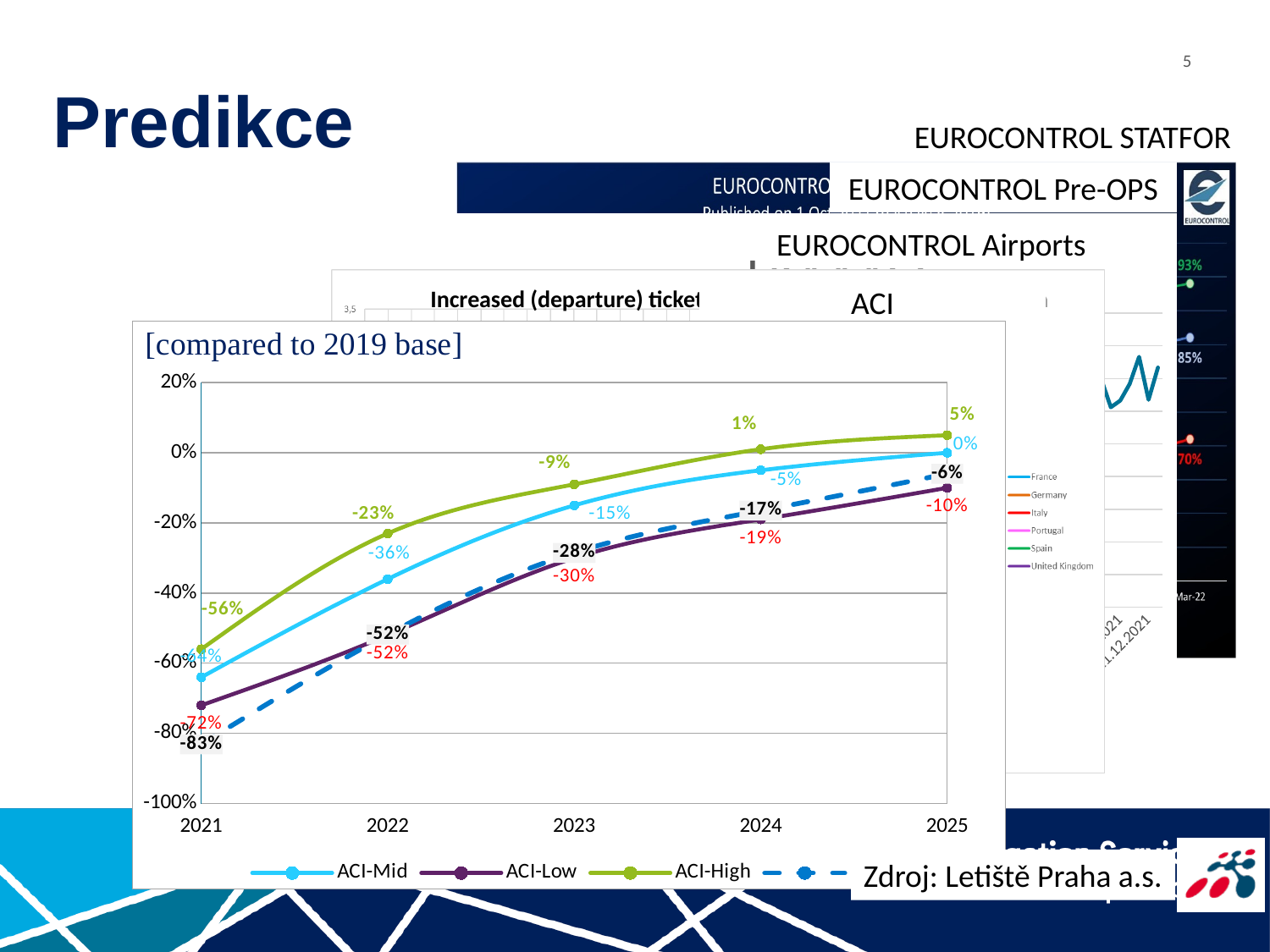
In the front chart '[compared to 2019 base]', what is the ACI-Low value for 2023? -30% In the front chart '[compared to 2019 base]', what is the difference between the ACI-High and ACI-Mid values in 2022? 13 percentage points How many years are shown on the x axis of the front chart '[compared to 2019 base]'? 5 In the front chart '[compared to 2019 base]', in which year does the ACI-High series reach its highest value? 2025 In the front chart '[compared to 2019 base]', what is the ACI-Mid value for 2023? -15% What kind of chart is the front chart '[compared to 2019 base]'? line chart In the front chart '[compared to 2019 base]', what is the ACI-Low value for 2025? -10% In the front chart '[compared to 2019 base]', what is the ACI-Mid value for 2025? 0% In the front chart '[compared to 2019 base]', what is the ACI-High value for 2021? -56% In the front chart '[compared to 2019 base]', which is higher in 2024, ACI-High or ACI-Low? ACI-High In the front chart '[compared to 2019 base]', do the series rise or fall from 2021 to 2025? rise In the front chart '[compared to 2019 base]', what is the ACI-High value for 2025? 5%